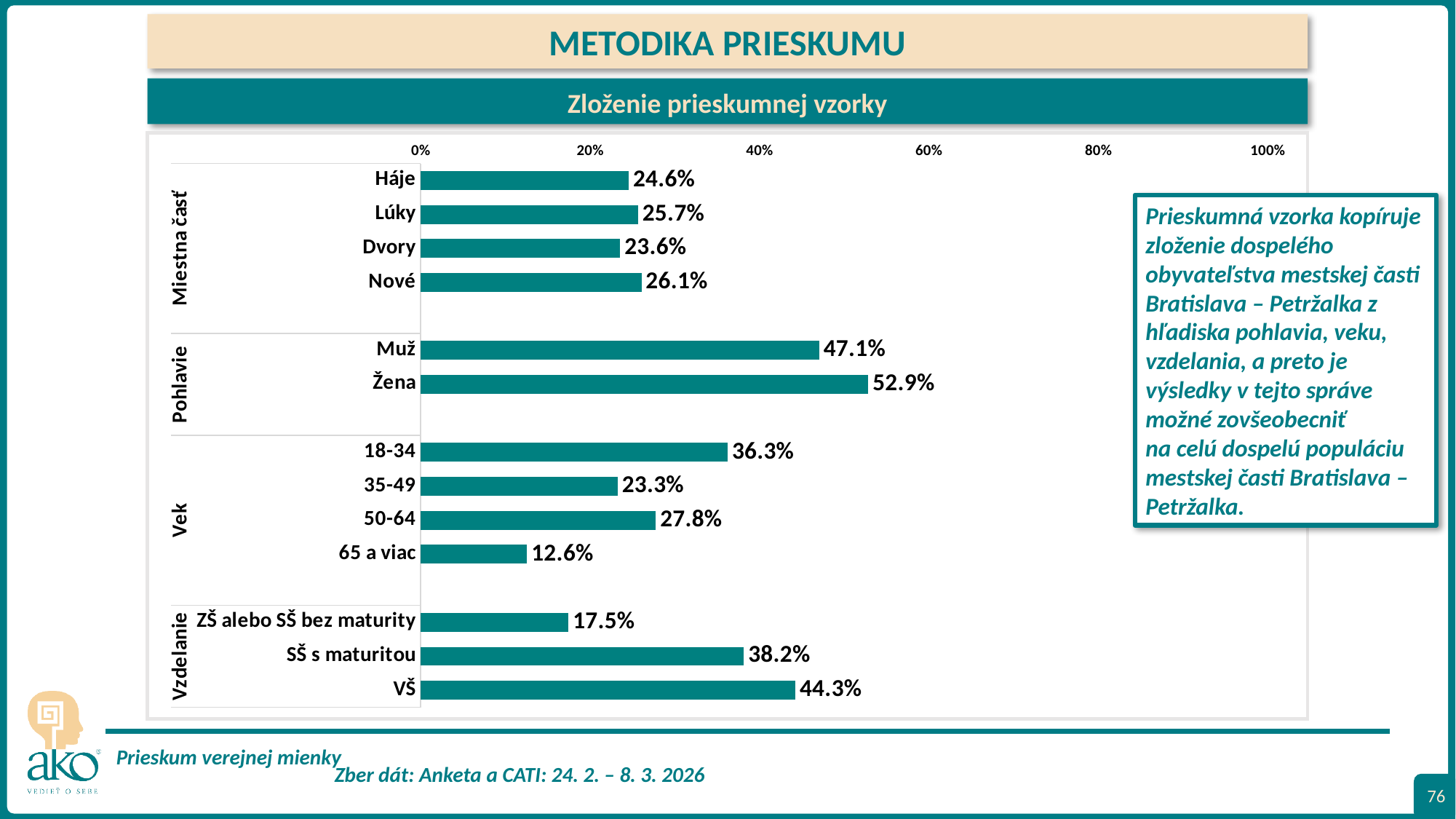
What is the total of the values for Muž and Žena? 100.0% Which category has the highest value in the chart? Žena What is the title of the chart? Zloženie prieskumnej vzorky What kind of chart is shown on the slide? bar chart What is the difference between the values for Žena and Muž? 5.8% Which category has the lowest value in the chart? 65 a viac How many categories are plotted in the chart? 13 Is the value for VŠ greater or less than 40%? greater What is the value for 65 a viac? 12.6% What is the value for Žena? 52.9% Which is larger, the value for Nové or the value for Dvory? Nové What is the value for SŠ s maturitou? 38.2%